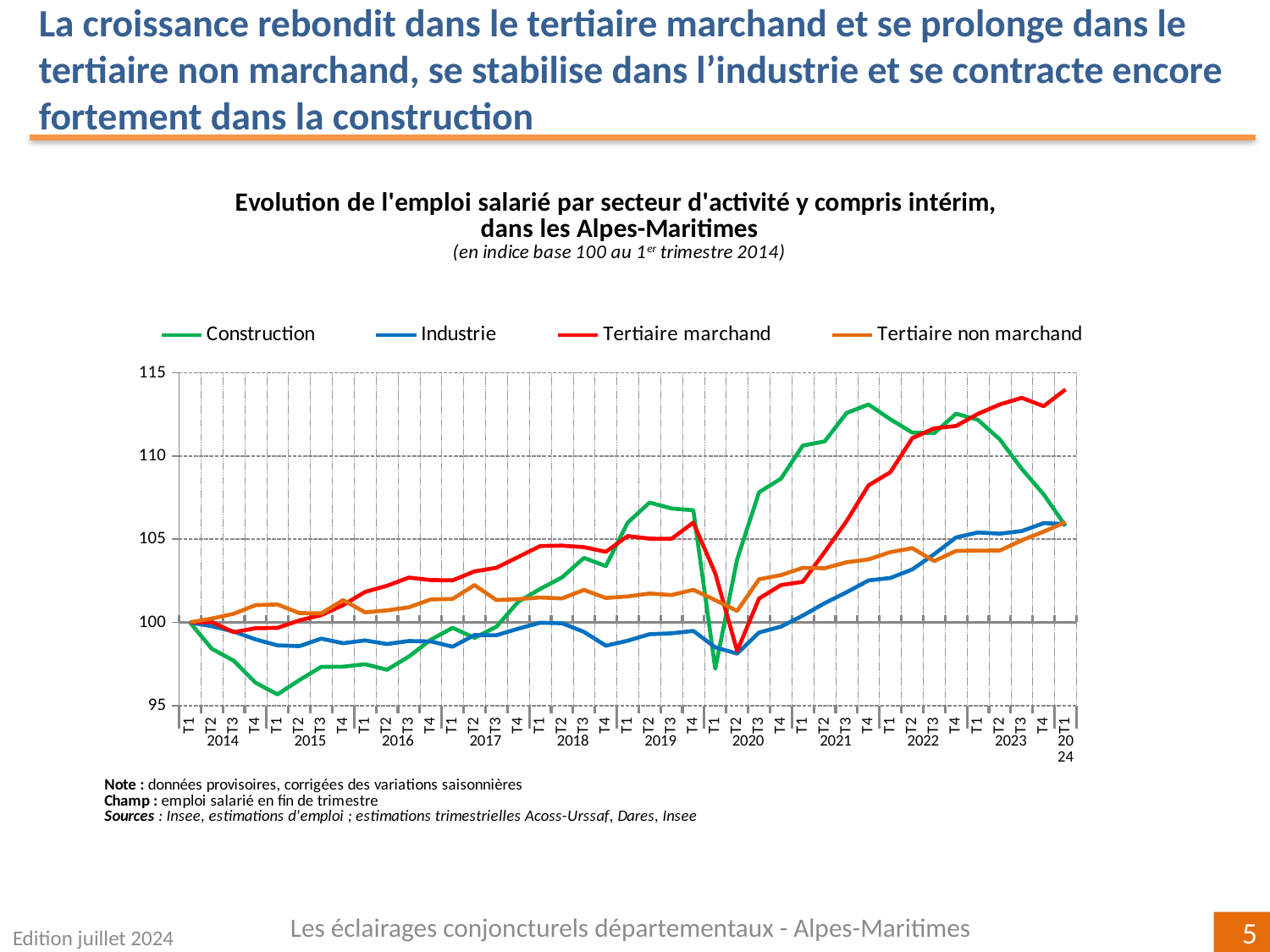
Is the value for Industrie at T1 2015 greater or less than 100? less Which series has the highest value at T1 2024? Tertiaire marchand Is the value for Tertiaire marchand at T1 2024 greater or less than 110? greater Does the Construction series rise or fall from T4 2021 to T1 2024? fall What kind of chart is shown on the slide? line chart Is the value for Construction at T4 2021 greater or less than 110? greater How many series does the legend list? 4 What is the value of all four series at T1 2014? 100 Which series is shown in red in the legend? Tertiaire marchand At T4 2021, which is larger: Construction or Tertiaire marchand? Construction Which series has the lowest value at T1 2015? Construction